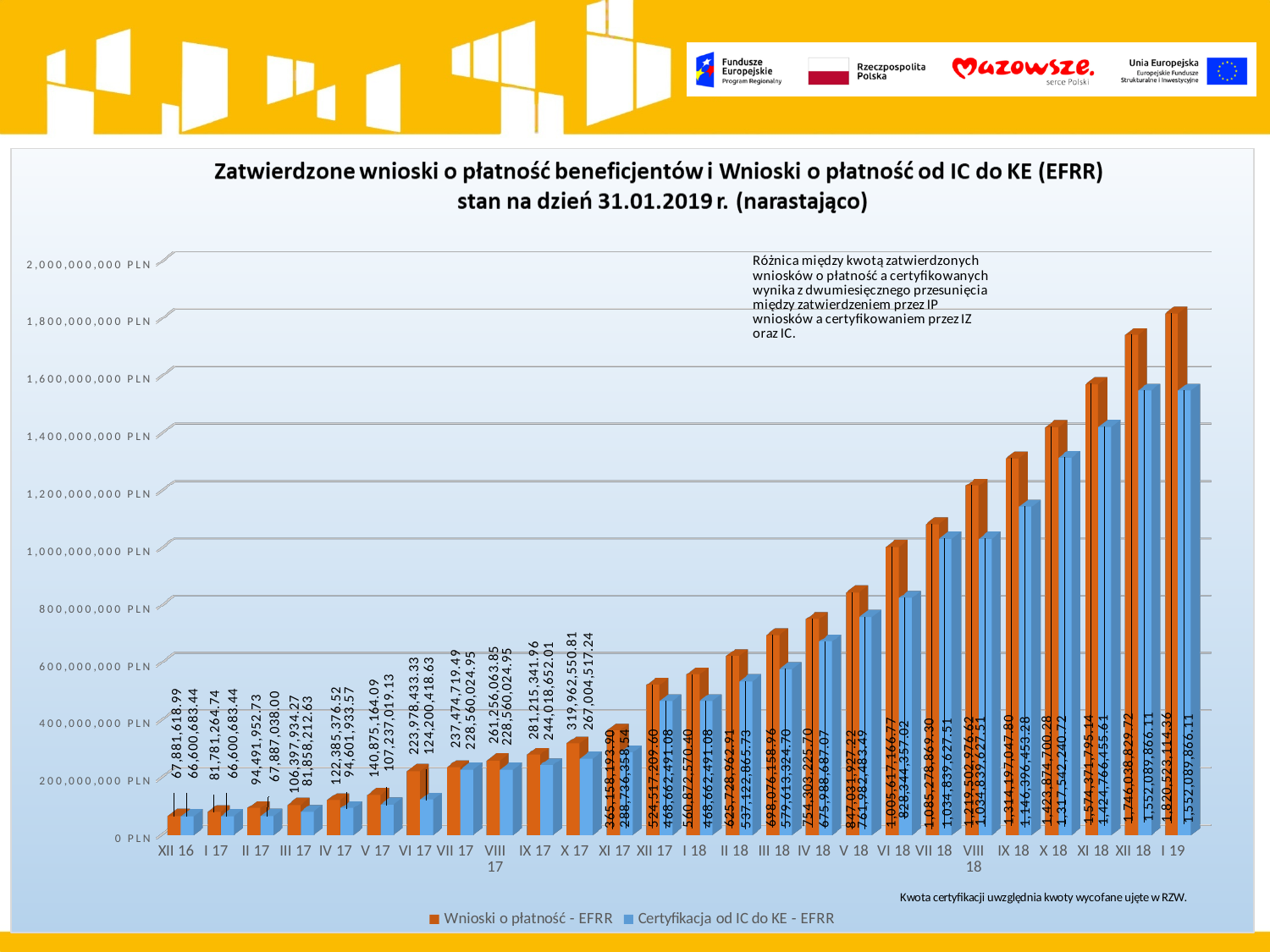
How many series does the legend list? 2 What is the value of Wnioski o płatność - EFRR for XII 16? 67,881,618.99 What is the value of Wnioski o płatność - EFRR for I 19? 1,820,523,114.36 How many periods are shown on the x axis? 26 What kind of chart is shown on the slide? bar chart Is the value of Certyfikacja od IC do KE - EFRR for XII 18 greater or less than 1,400,000,000 PLN? greater What is the value of Certyfikacja od IC do KE - EFRR for VII 17? 228,560,024.95 For VI 18, which series has the larger value: Wnioski o płatność - EFRR or Certyfikacja od IC do KE - EFRR? Wnioski o płatność - EFRR Which period has the highest value for Wnioski o płatność - EFRR? I 19 For I 19, what is the difference between Wnioski o płatność - EFRR and Certyfikacja od IC do KE - EFRR? 268,433,248.25 Which period has the lowest value for Wnioski o płatność - EFRR? XII 16 What is the value of Certyfikacja od IC do KE - EFRR for XII 18? 1,552,089,866.11